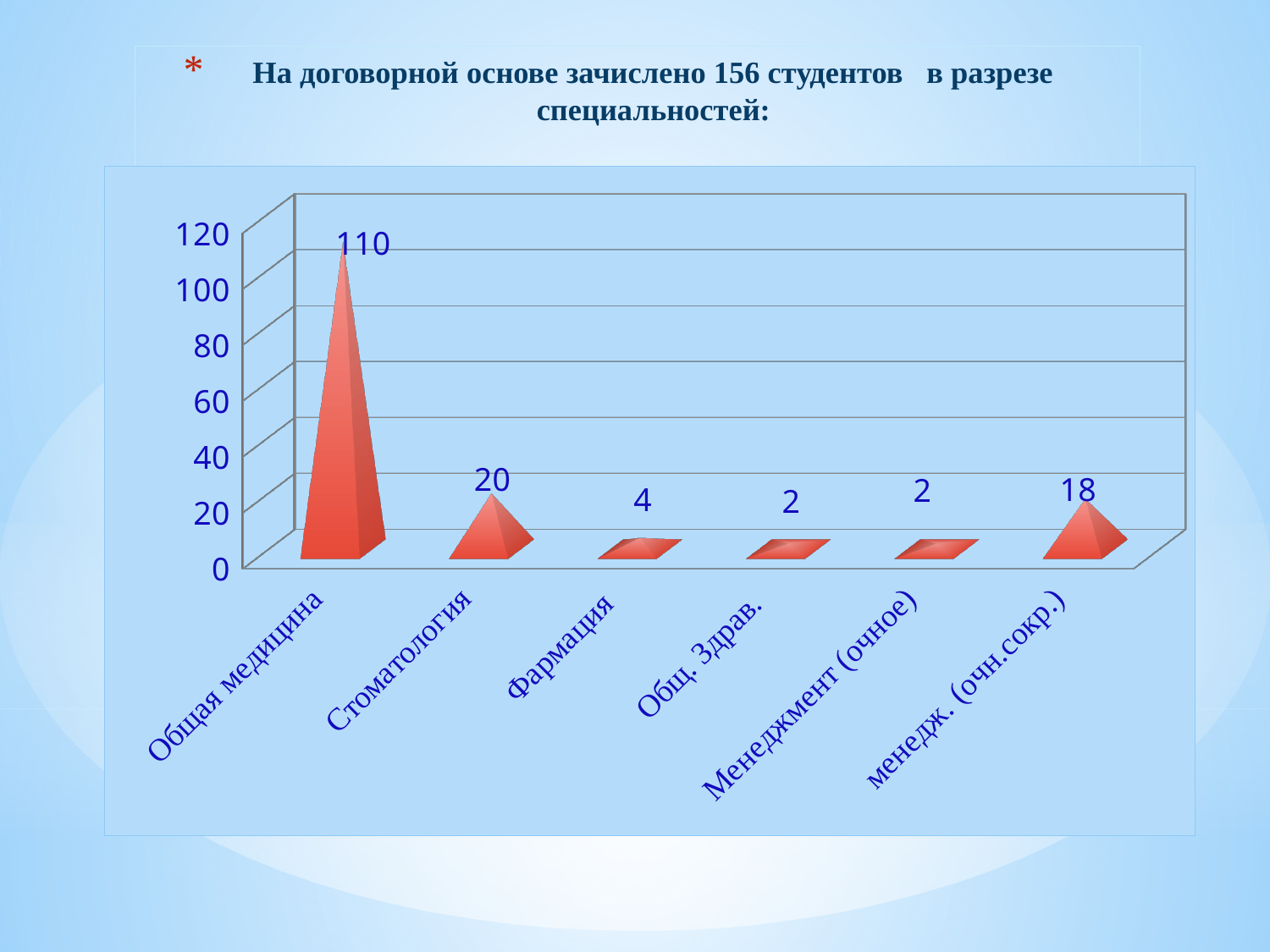
What is the difference between the values for Общая медицина and Стоматология? 90 How many categories are shown on the x axis? 6 What is the highest value shown on the vertical axis? 120 Is the value for Общая медицина greater or less than 100? greater What is the value for менедж. (очн.сокр.)? 18 What is the value for Фармация? 4 What is the difference between the values for Стоматология and менедж. (очн.сокр.)? 2 What is the value for Общая медицина? 110 What is the value for Стоматология? 20 Which is larger, the value for Фармация or the value for Общ. Здрав.? Фармация Which category has the highest value? Общая медицина What kind of chart is shown on the slide? bar chart